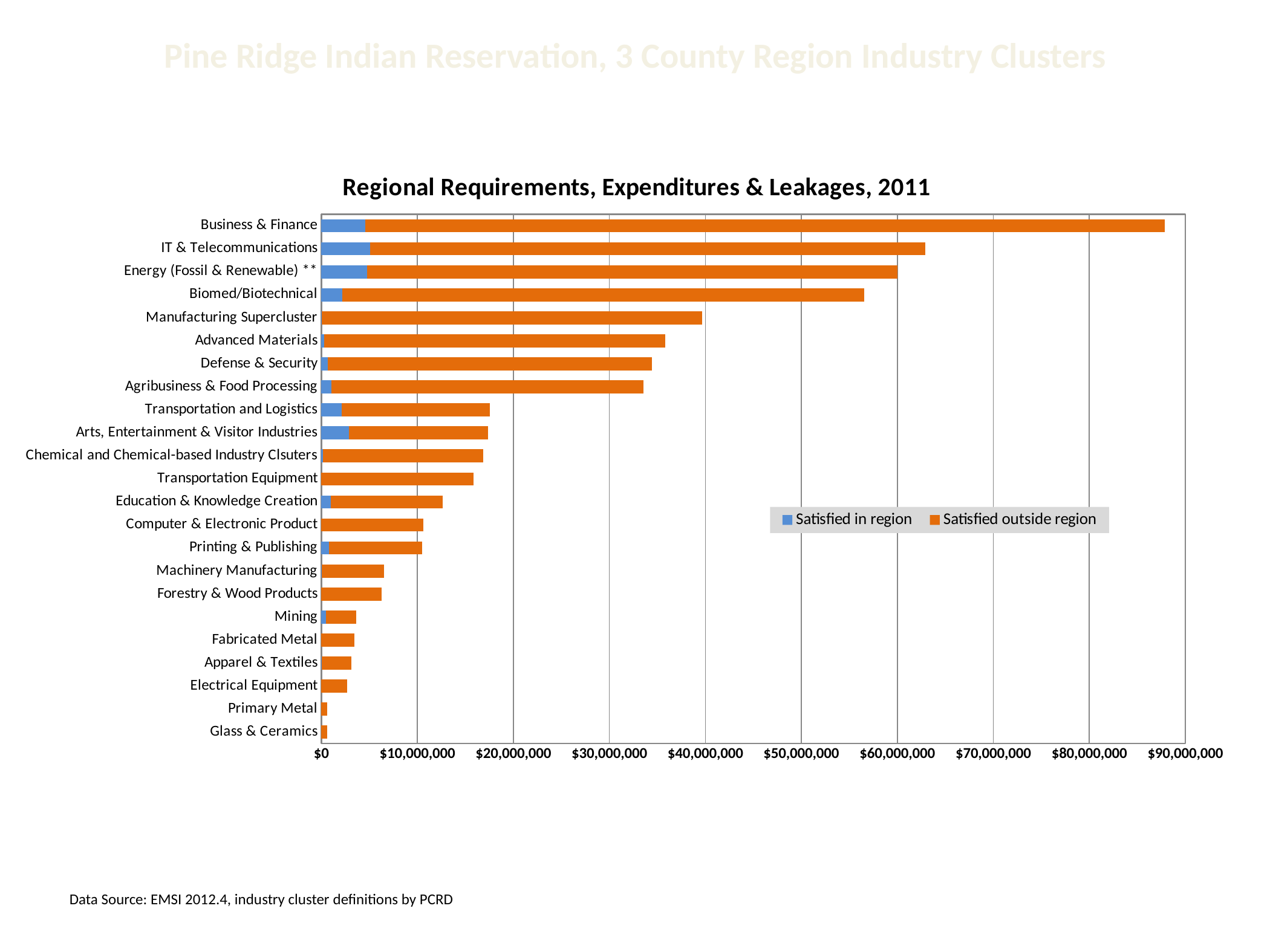
How many industry clusters are listed on the chart? 23 Which industry cluster has the longest total bar? Business & Finance Is the total value for Machinery Manufacturing greater or less than $10,000,000? less Is the total value for Transportation and Logistics greater or less than $20,000,000? less How many series does the legend list? 2 Is the total value for Biomed/Biotechnical greater or less than $50,000,000? greater What is the title of the chart? Regional Requirements, Expenditures & Leakages, 2011 Do the total bar lengths generally increase or decrease going from the top category to the bottom category? decrease Which has a larger total bar, Business & Finance or IT & Telecommunications? Business & Finance What kind of chart is shown on the slide? bar chart